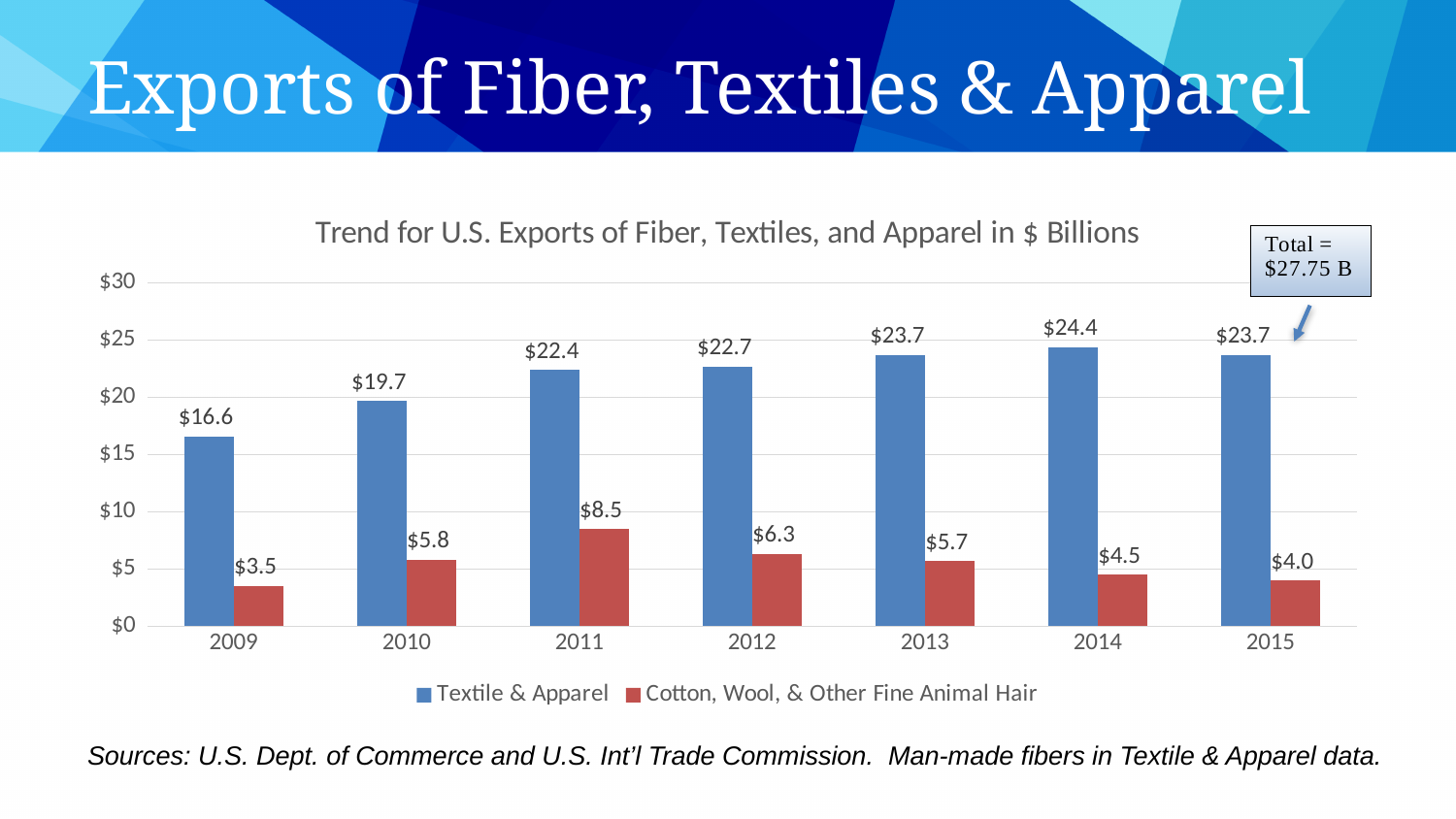
What is the title of the chart? Trend for U.S. Exports of Fiber, Textiles, and Apparel in $ Billions Which year has the highest Textile & Apparel value? 2014 Which is larger: Cotton, Wool, & Other Fine Animal Hair in 2012 or in 2013? 2012 What kind of chart is shown on the slide? Bar chart Which year has the lowest Cotton, Wool, & Other Fine Animal Hair value? 2009 What is the value for Textile & Apparel in 2014? $24.4 What is the difference between the Textile & Apparel values for 2015 and 2009? $7.1 Does the Cotton, Wool, & Other Fine Animal Hair value rise or fall from 2011 to 2015? Fall What is the combined value of the two series in 2010? $25.5 What is the value for Cotton, Wool, & Other Fine Animal Hair in 2011? $8.5 How many years are shown on the x axis? 7 How many series does the legend list? 2